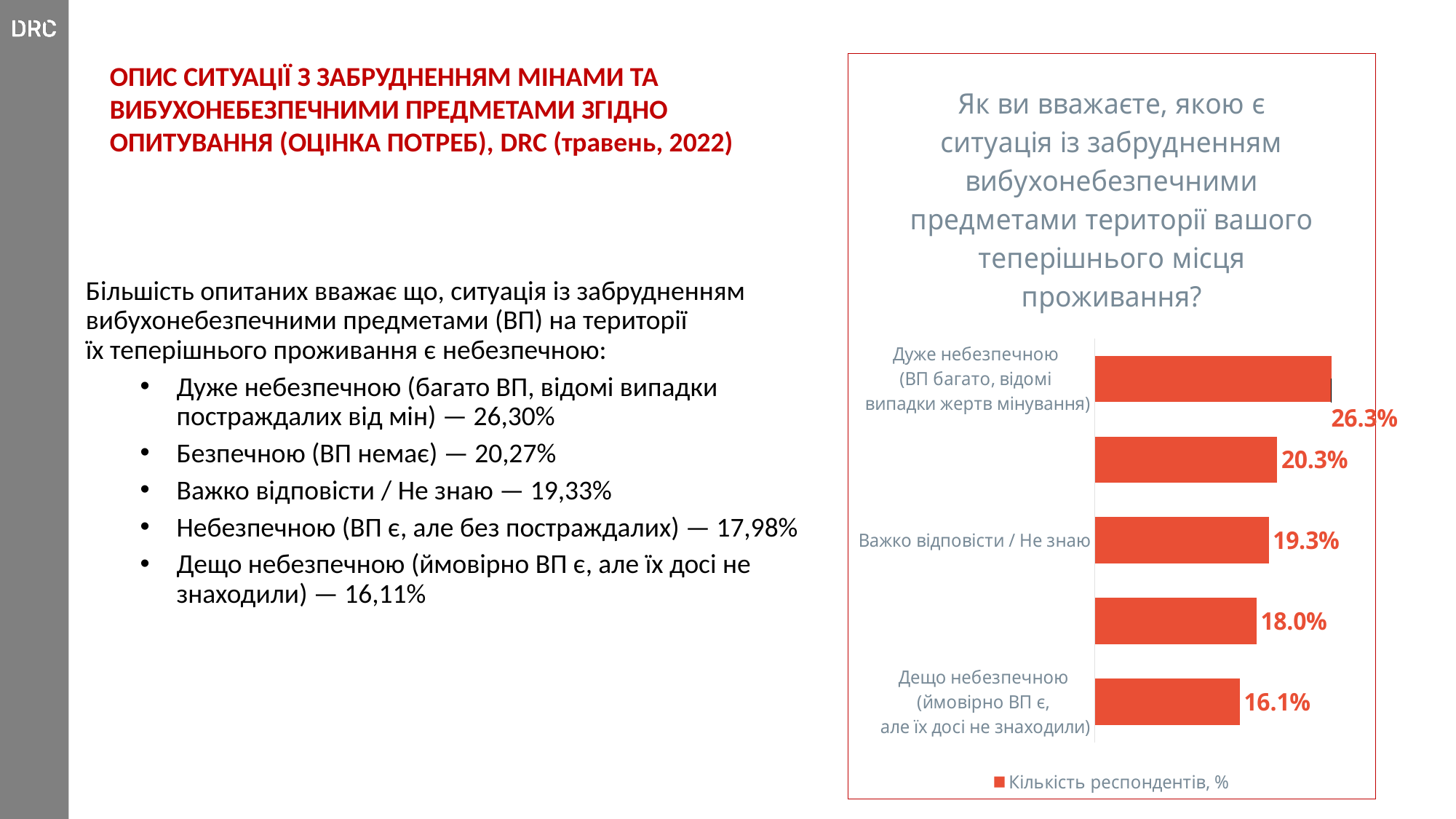
Which category has the highest value in the chart? Дуже небезпечною (ВП багато, відомі випадки жертв мінування) What is the value for "Дуже небезпечною (ВП багато, відомі випадки жертв мінування)"? 26.3% How many series does the chart's legend list? 1 Which is larger: the value for "Дуже небезпечною" or the value for "Важко відповісти / Не знаю"? Дуже небезпечною What is the difference between the values for "Дуже небезпечною" and "Дещо небезпечною"? 10.2 percentage points Which category has the lowest value in the chart? Дещо небезпечною (ймовірно ВП є, але їх досі не знаходили) How many bars does the chart contain? 5 What kind of chart is shown on the slide? Bar chart What is the difference between the values for "Важко відповісти / Не знаю" and "Дещо небезпечною"? 3.2 percentage points What is the value for "Важко відповісти / Не знаю"? 19.3% What is the legend entry shown below the chart? Кількість респондентів, % What is the value for "Дещо небезпечною (ймовірно ВП є, але їх досі не знаходили)"? 16.1%